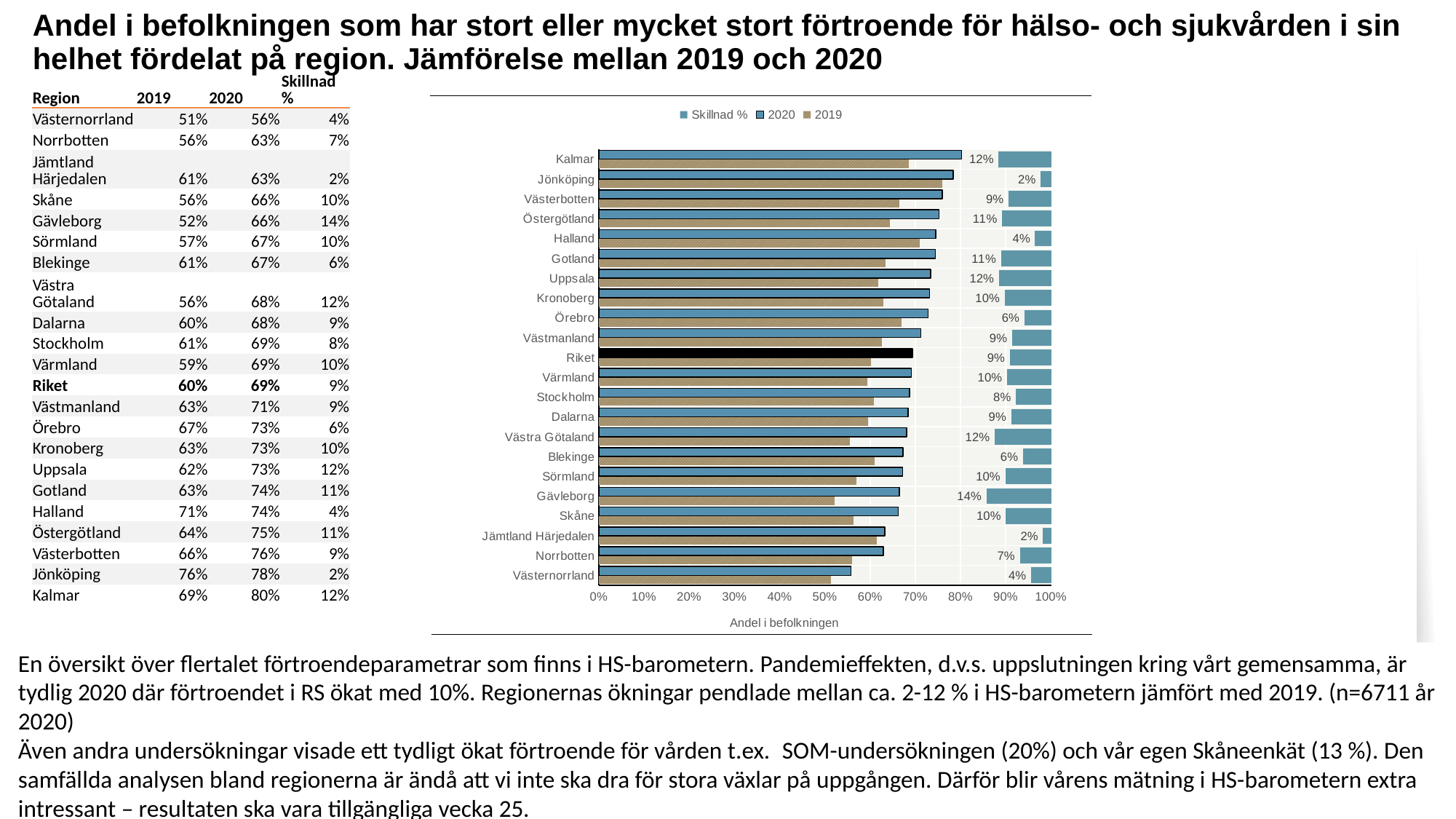
What kind of chart is shown on the slide? bar chart What is the Skillnad % value for Gävleborg? 14% Is the 2020 value for Kalmar greater or less than 70%? greater Which region has the highest Skillnad % value? Gävleborg How many series does the chart legend list? 3 Which region has the longest 2020 bar? Kalmar Which region has the shortest 2020 bar? Västernorrland How many regions (including Riket) are plotted on the chart? 22 Which has the larger Skillnad % value, Kalmar or Halland? Kalmar What is the Skillnad % value for Riket? 9% What is the difference between the Skillnad % values for Gävleborg and Kalmar? 2% What is the Skillnad % value for Kalmar? 12%